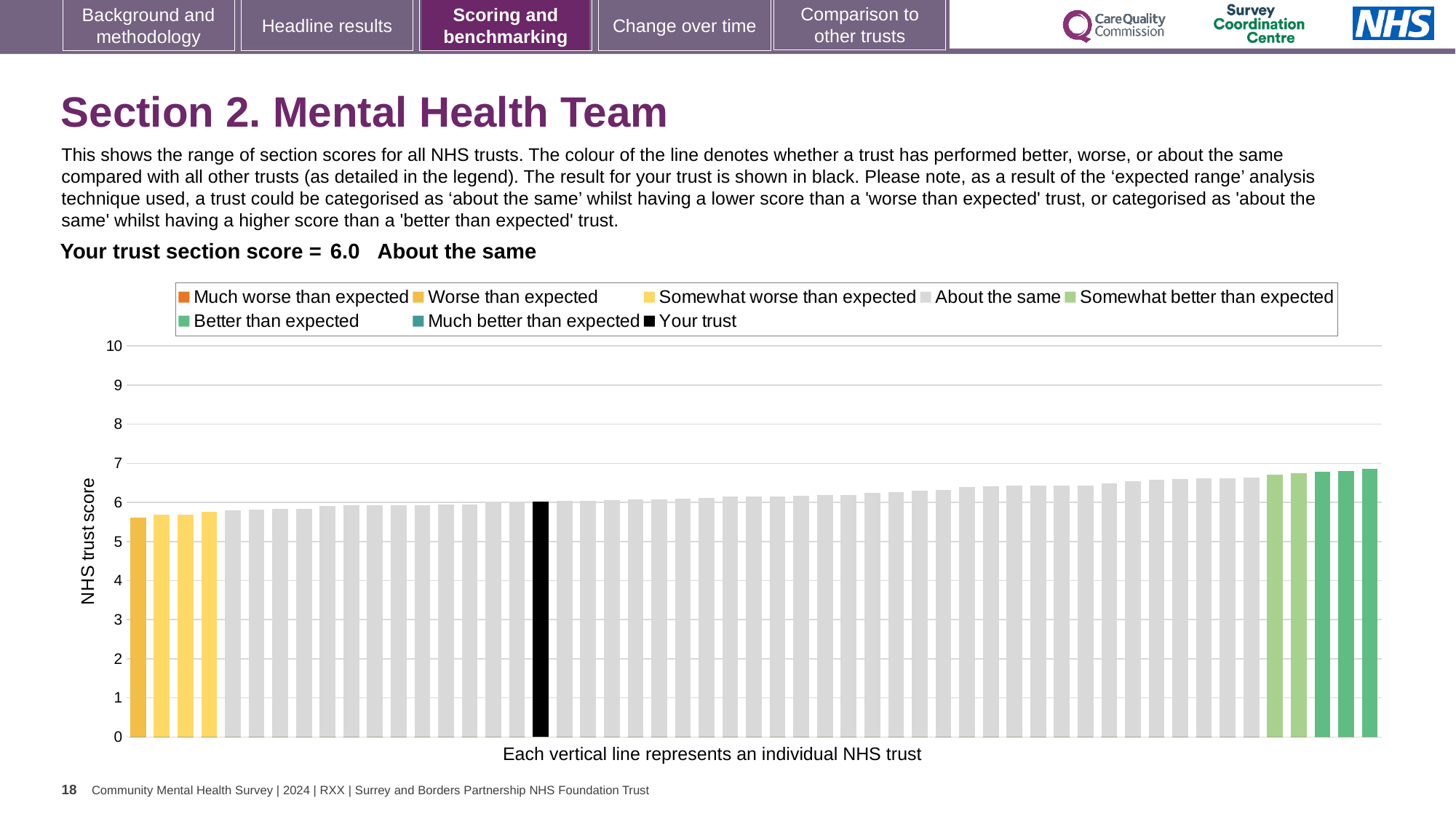
Is the value of the tallest bar greater or less than 7? less Is the value of the shortest bar greater or less than 5? greater What is the label on the vertical axis of the chart? NHS trust score What colour is the bar representing your trust? black What is the section score for your trust shown on the slide? 6.0 Which category is your trust's section score placed in? About the same What kind of chart is shown on the slide? bar chart Do the bar values rise or fall from left to right along the x axis? rise Is the value of the black 'Your trust' bar greater or less than 5? greater How many entries does the chart legend list? 8 How many bars are coloured green (somewhat better or better than expected)? 5 How many bars are coloured yellow (worse or somewhat worse than expected)? 4